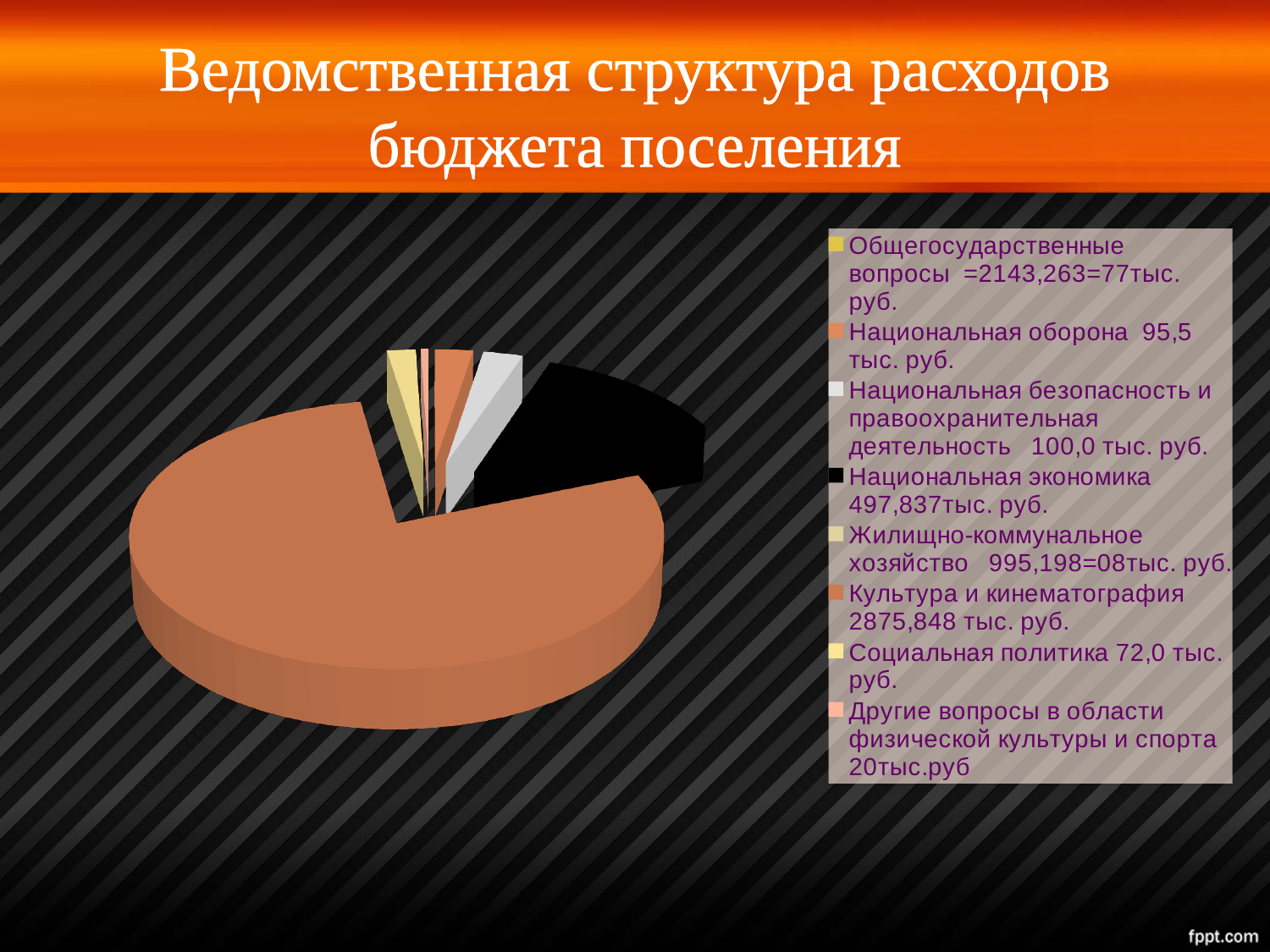
According to the legend, what is the value for Социальная политика? 72,0 тыс. руб. What is the title of the slide with the pie chart? Ведомственная структура расходов бюджета поселения According to the legend, what is the value for Культура и кинематография? 2875,848 тыс. руб. Which category has the largest value printed in the legend? Культура и кинематография What kind of chart is shown on the slide? Pie chart According to the legend, what is the value for Национальная экономика? 497,837 тыс. руб. According to the legend, what is the value for Национальная безопасность и правоохранительная деятельность? 100,0 тыс. руб. How many categories does the legend of the pie chart list? 8 According to the legend, what is the value for Национальная оборона? 95,5 тыс. руб. Which is larger according to the legend: Национальная оборона or Социальная политика? Национальная оборона What is the difference between the legend values for Национальная безопасность и правоохранительная деятельность and Социальная политика? 28,0 тыс. руб. Which category has the smallest value printed in the legend? Другие вопросы в области физической культуры и спорта